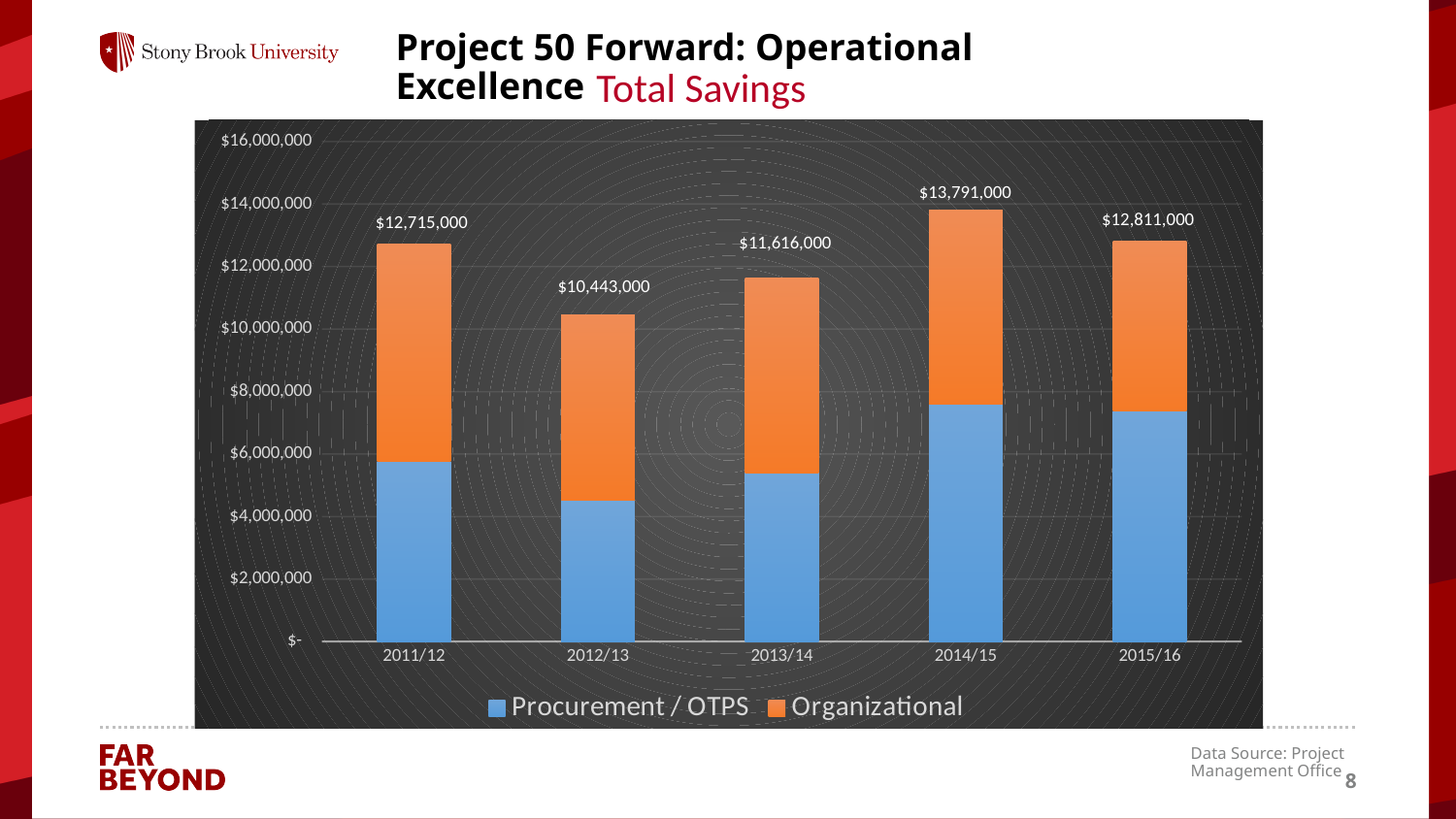
How many years are shown on the x axis? 5 Is the Procurement / OTPS value for 2012/13 greater or less than $6,000,000? less What kind of chart is shown on the slide? Stacked bar chart Which year has a larger total savings, 2011/12 or 2013/14? 2011/12 What is the total savings shown for 2012/13? $10,443,000 What is the total savings shown for 2015/16? $12,811,000 What is the total savings shown for 2014/15? $13,791,000 Which year has the highest total savings? 2014/15 What is the difference between the total savings in 2014/15 and 2012/13? $3,348,000 Is the Procurement / OTPS value for 2014/15 greater or less than $6,000,000? greater Which year has the lowest total savings? 2012/13 How many series does the legend list? 2